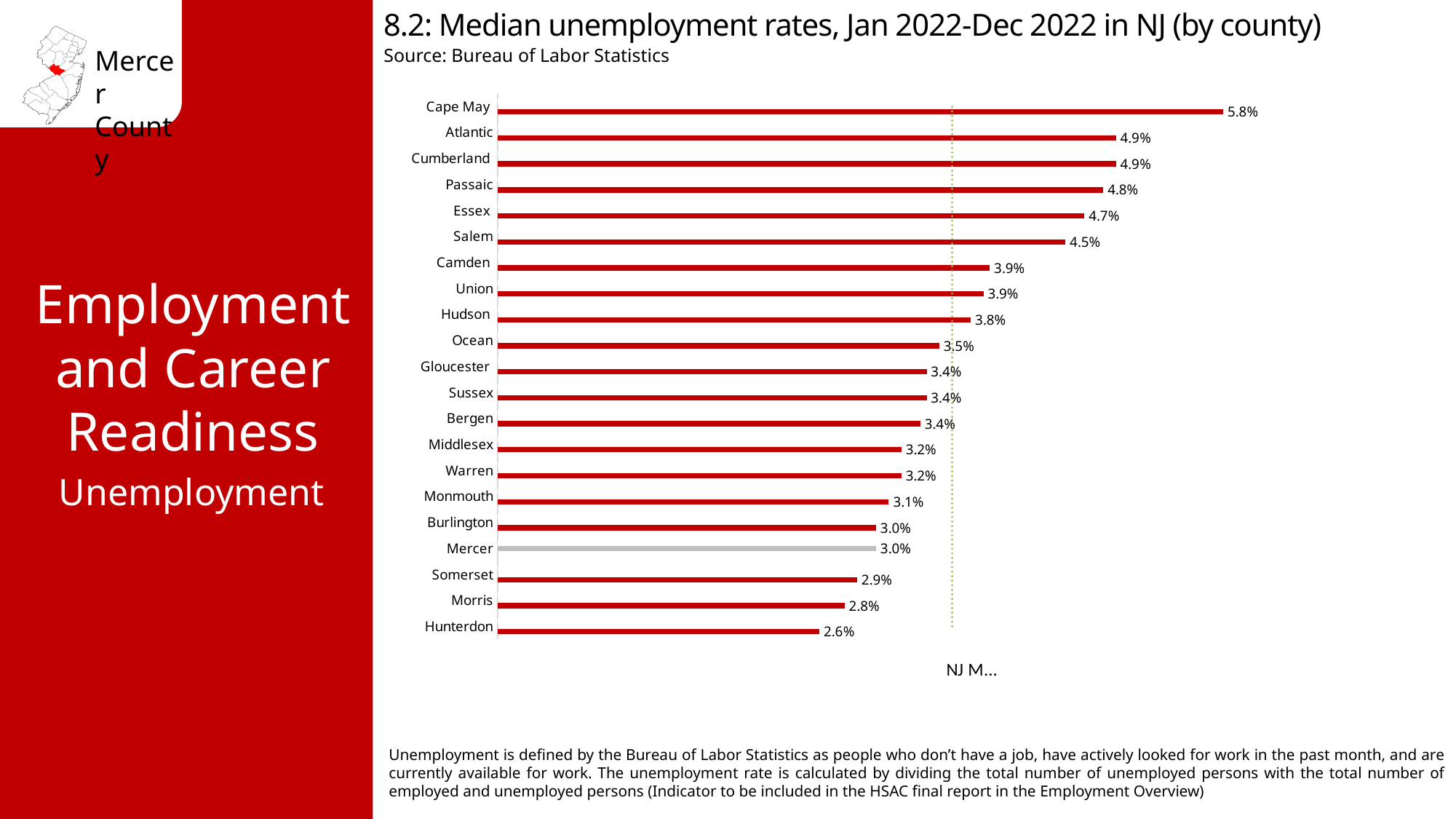
What is the median unemployment rate for Cape May? 5.8% What is the median unemployment rate for Mercer County? 3.0% Which county has the lowest median unemployment rate? Hunterdon What is the median unemployment rate for Hudson? 3.8% What is the difference between the median unemployment rates of Salem and Mercer? 1.5% Which county has the highest median unemployment rate? Cape May Which has a higher median unemployment rate, Essex or Camden? Essex What is the difference between the median unemployment rates of Cape May and Hunterdon? 3.2% What type of chart is used to show the median unemployment rates? Bar chart How many counties are shown in the chart? 21 Which county's bar is shown in grey instead of red? Mercer Which has a higher median unemployment rate, Morris or Monmouth? Monmouth